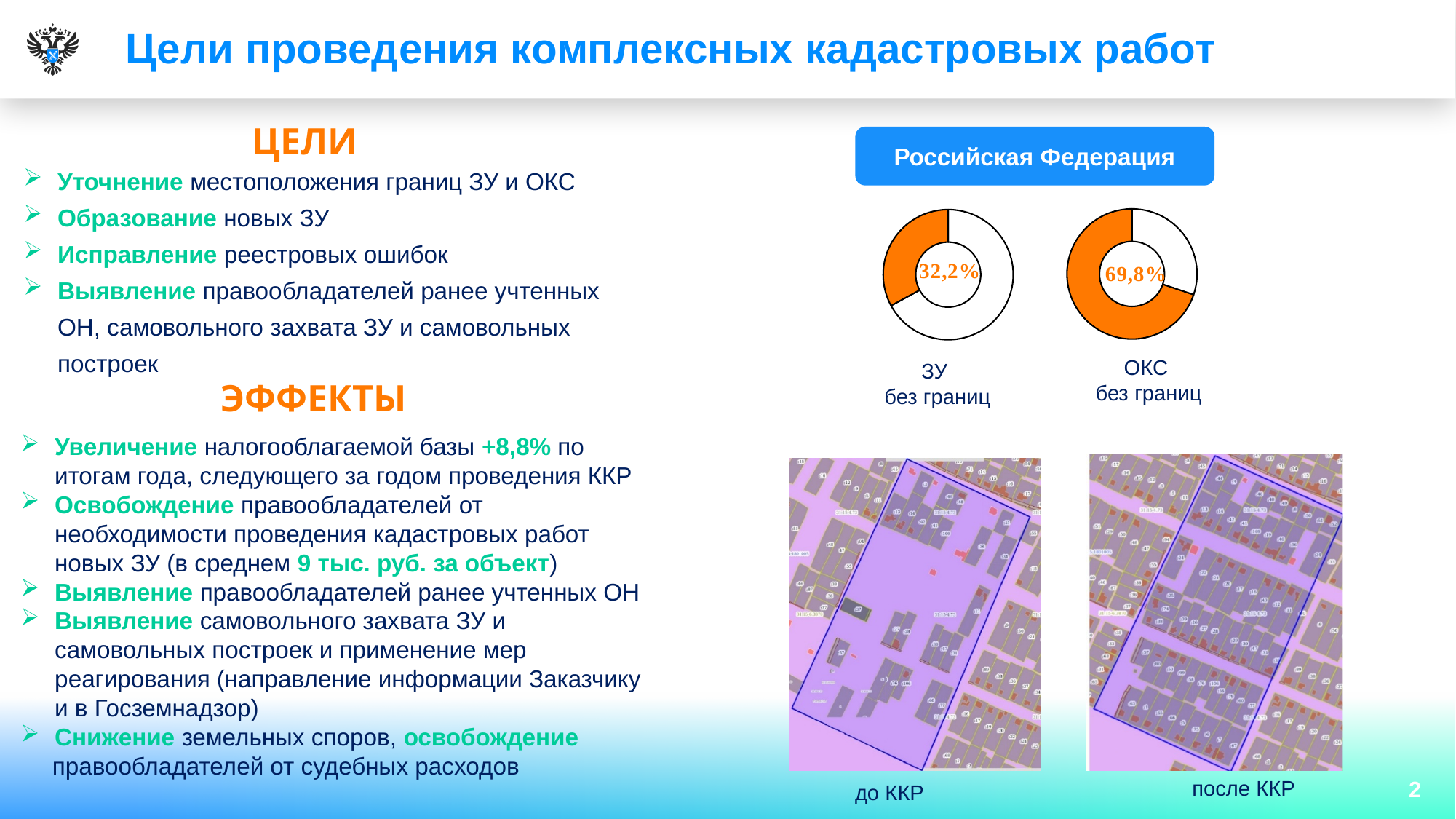
How many donut charts are shown under the heading 'Российская Федерация'? 2 What percentage is shown in the left donut chart labelled 'ЗУ без границ'? 32,2% Which of the two donut charts shows the larger highlighted share, 'ЗУ без границ' or 'ОКС без границ'? ОКС без границ Is the highlighted share in the 'ОКС без границ' chart greater or less than 50%? greater What colour is used for the highlighted share in both donut charts? Orange What type of chart is used to show the 'ЗУ без границ' and 'ОКС без границ' values? Donut (pie) chart What share of the 'ЗУ без границ' donut is not highlighted in orange? 67,8% Is the highlighted share in the 'ЗУ без границ' chart greater or less than 50%? less What heading appears above the two donut charts? Российская Федерация What percentage is shown in the right donut chart labelled 'ОКС без границ'? 69,8% What share of the 'ОКС без границ' donut is not highlighted in orange? 30,2% What is the difference in percentage points between the value in the 'ОКС без границ' chart and the value in the 'ЗУ без границ' chart? 37,6